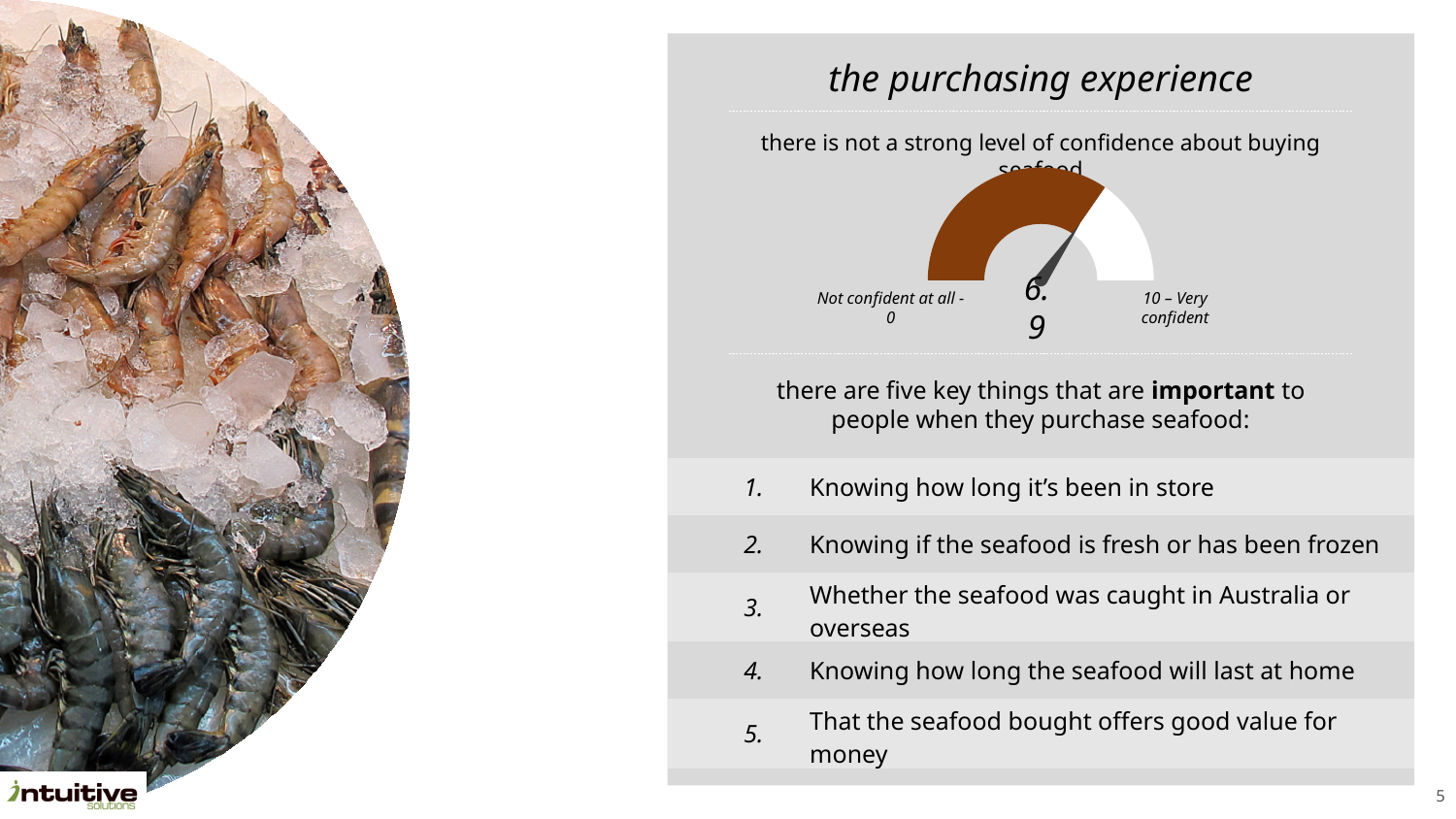
What label appears at the left end of the gauge scale? Not confident at all - 0 What kind of chart is used to show the level of confidence about buying seafood? gauge chart What confidence score does the gauge chart show? 6.9 Is the confidence value shown on the gauge greater or less than 5? greater What label appears at the right end of the gauge scale? 10 – Very confident What is the minimum value of the gauge's scale? 0 What is the maximum value of the gauge's scale? 10 Is the confidence value shown on the gauge greater or less than 10? less